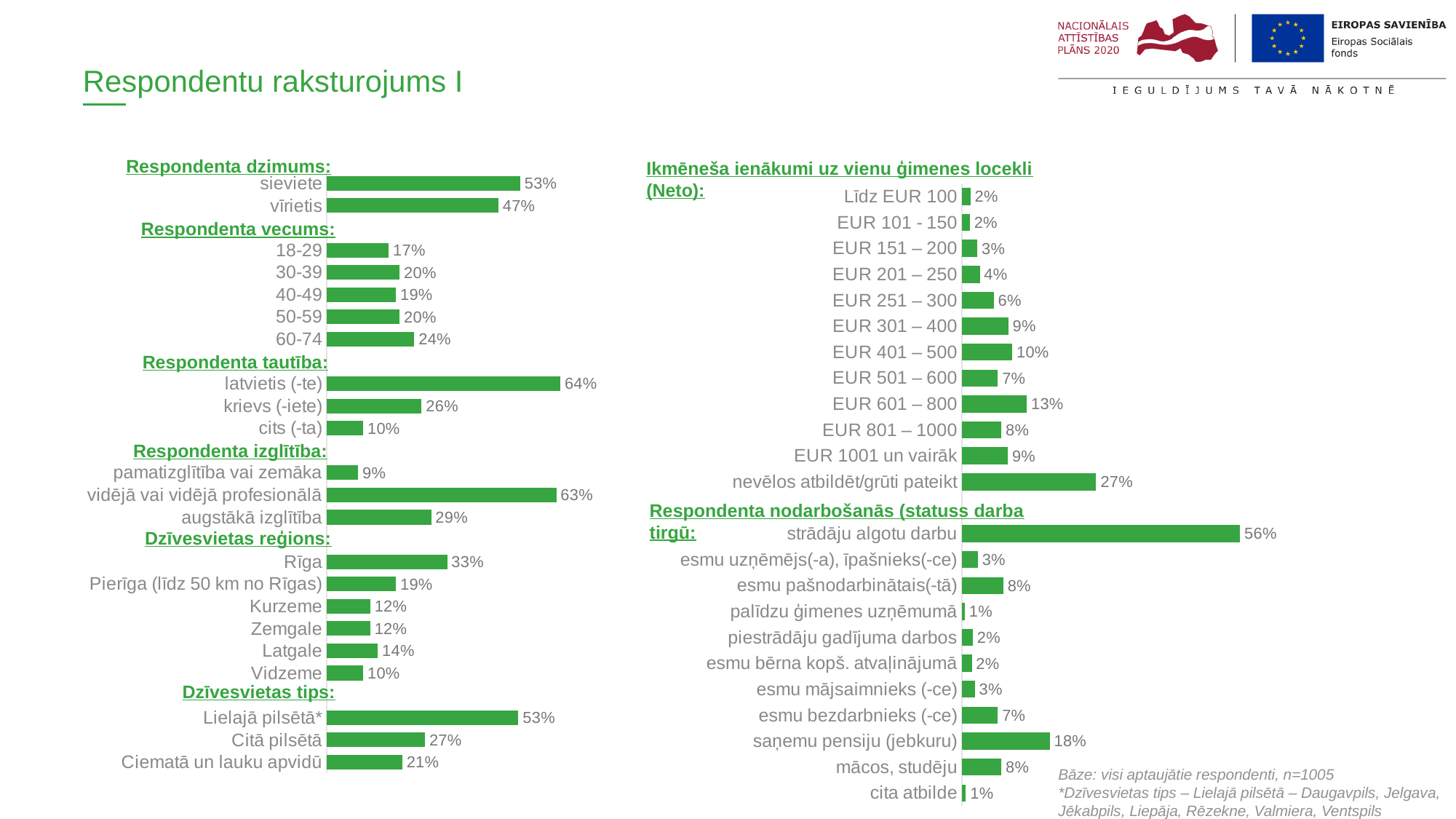
In the right chart, what is the value for 'EUR 601 – 800'? 13% What type of chart is used on this slide? Bar chart In the left chart, what is the difference between 'latvietis (-te)' and 'krievs (-iete)'? 38% In the left chart, what is the value for 'augstākā izglītība'? 29% In the right chart, which income category has the highest share? nevēlos atbildēt/grūti pateikt In the right chart, which is larger: 'EUR 401 – 500' or 'EUR 501 – 600'? EUR 401 – 500 In the left chart, what percentage of respondents are 'sieviete'? 53% In the left chart, which is larger: 'Rīga' or 'Pierīga (līdz 50 km no Rīgas)'? Rīga In the right chart, what is the value for 'strādāju algotu darbu'? 56% In the left chart, which age group under 'Respondenta vecums' has the highest share? 60-74 In the right chart, what is the difference between 'saņemu pensiju (jebkuru)' and 'esmu bezdarbnieks (-ce)'? 11% In the left chart, how many categories are listed under 'Dzīvesvietas reģions'? 6